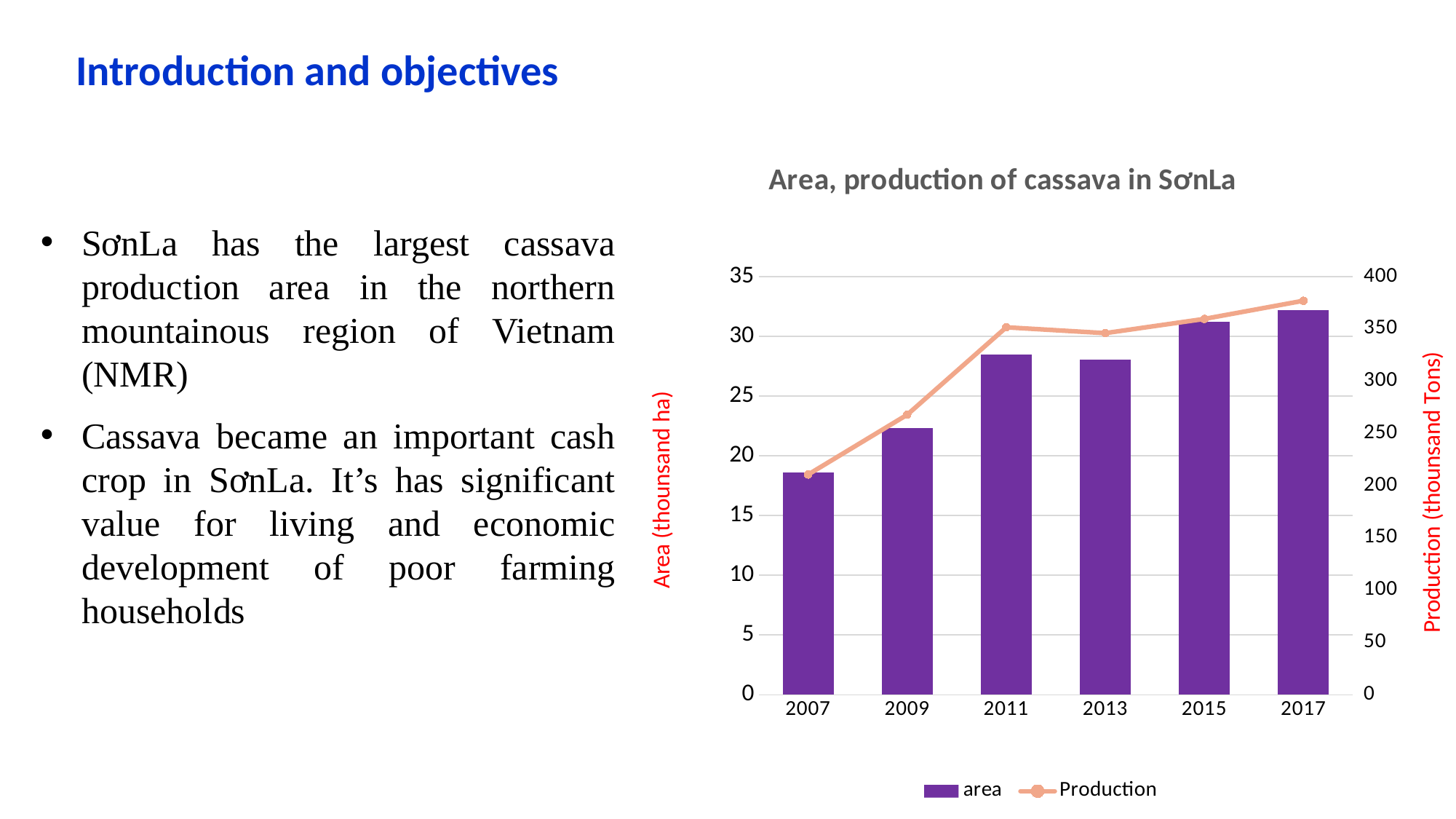
Is the production value for 2011 greater or less than 300? greater What kind of chart is shown on the slide? A combined bar and line chart How many series does the chart's legend list? 2 Which year has the highest cassava production in the chart? 2017 Which year has the larger cassava area, 2009 or 2011? 2011 Is the area value for 2007 greater or less than 20? less Is the area value for 2017 greater or less than 30? greater How many years are shown on the x axis of the chart? 6 Does the cassava area generally rise or fall from 2007 to 2017? rise Which year has the lowest cassava area in the chart? 2007 What is the title of the chart? Area, production of cassava in SơnLa